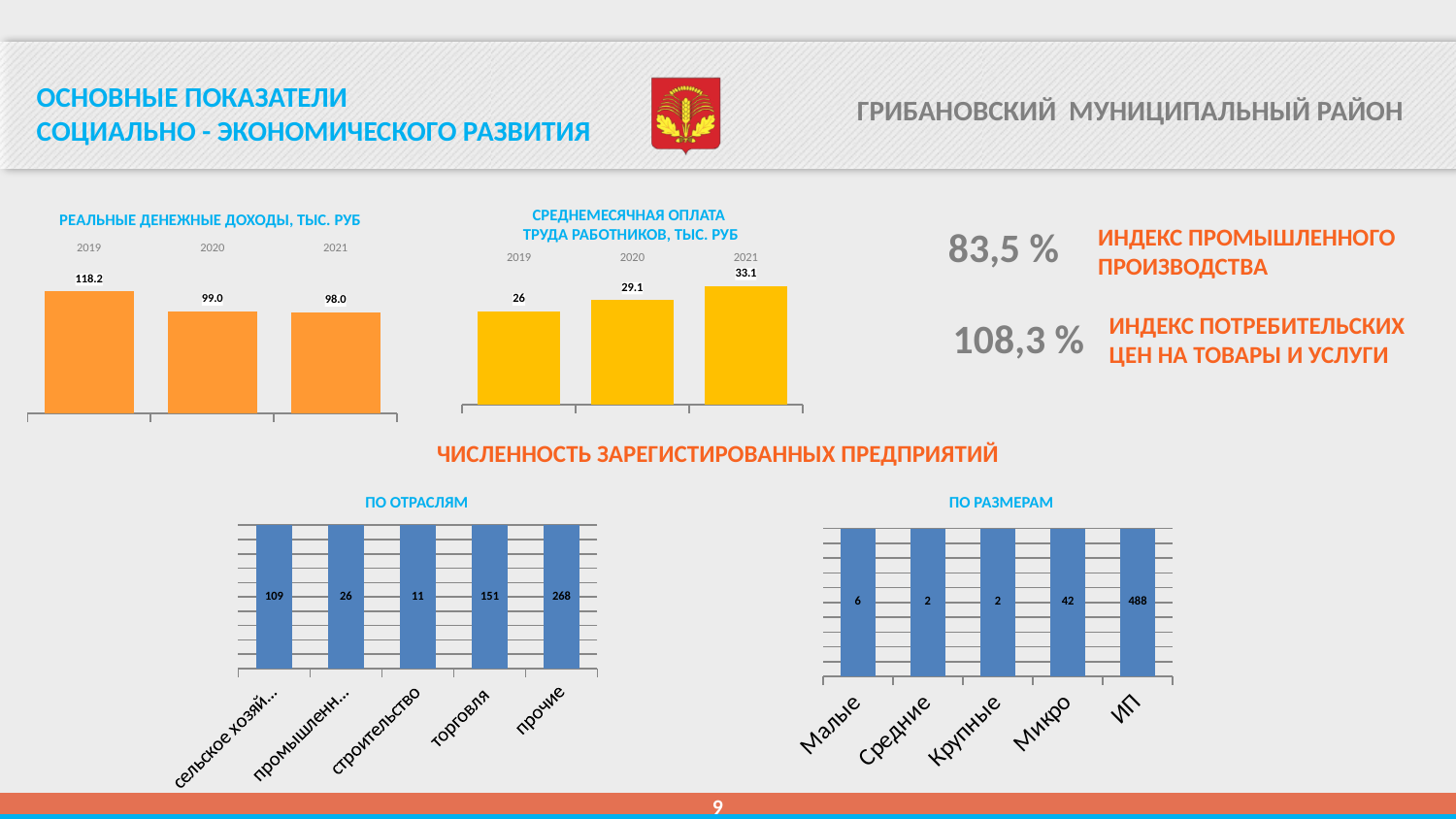
In the chart 'ПО ОТРАСЛЯМ', which category has the largest value? прочие In the chart 'СРЕДНЕМЕСЯЧНАЯ ОПЛАТА ТРУДА РАБОТНИКОВ, ТЫС. РУБ', what is the value for 2021? 33.1 In the chart 'РЕАЛЬНЫЕ ДЕНЕЖНЫЕ ДОХОДЫ, ТЫС. РУБ', which year has the lowest value? 2021 In the chart 'РЕАЛЬНЫЕ ДЕНЕЖНЫЕ ДОХОДЫ, ТЫС. РУБ', what is the value for 2019? 118.2 In the chart 'СРЕДНЕМЕСЯЧНАЯ ОПЛАТА ТРУДА РАБОТНИКОВ, ТЫС. РУБ', what is the difference between the 2021 and 2019 values? 7.1 In the chart 'РЕАЛЬНЫЕ ДЕНЕЖНЫЕ ДОХОДЫ, ТЫС. РУБ', do the values rise or fall from 2019 to 2021? fall In the chart 'ПО РАЗМЕРАМ', what is the value for ИП? 488 In the chart 'ПО РАЗМЕРАМ', which is larger, the value for Малые or the value for Микро? Микро How many categories are shown in the chart 'ПО ОТРАСЛЯМ'? 5 In the chart 'ПО ОТРАСЛЯМ', what is the value for торговля? 151 In the chart 'СРЕДНЕМЕСЯЧНАЯ ОПЛАТА ТРУДА РАБОТНИКОВ, ТЫС. РУБ', do the values rise or fall from 2019 to 2021? rise What kind of chart is 'СРЕДНЕМЕСЯЧНАЯ ОПЛАТА ТРУДА РАБОТНИКОВ, ТЫС. РУБ'? bar chart